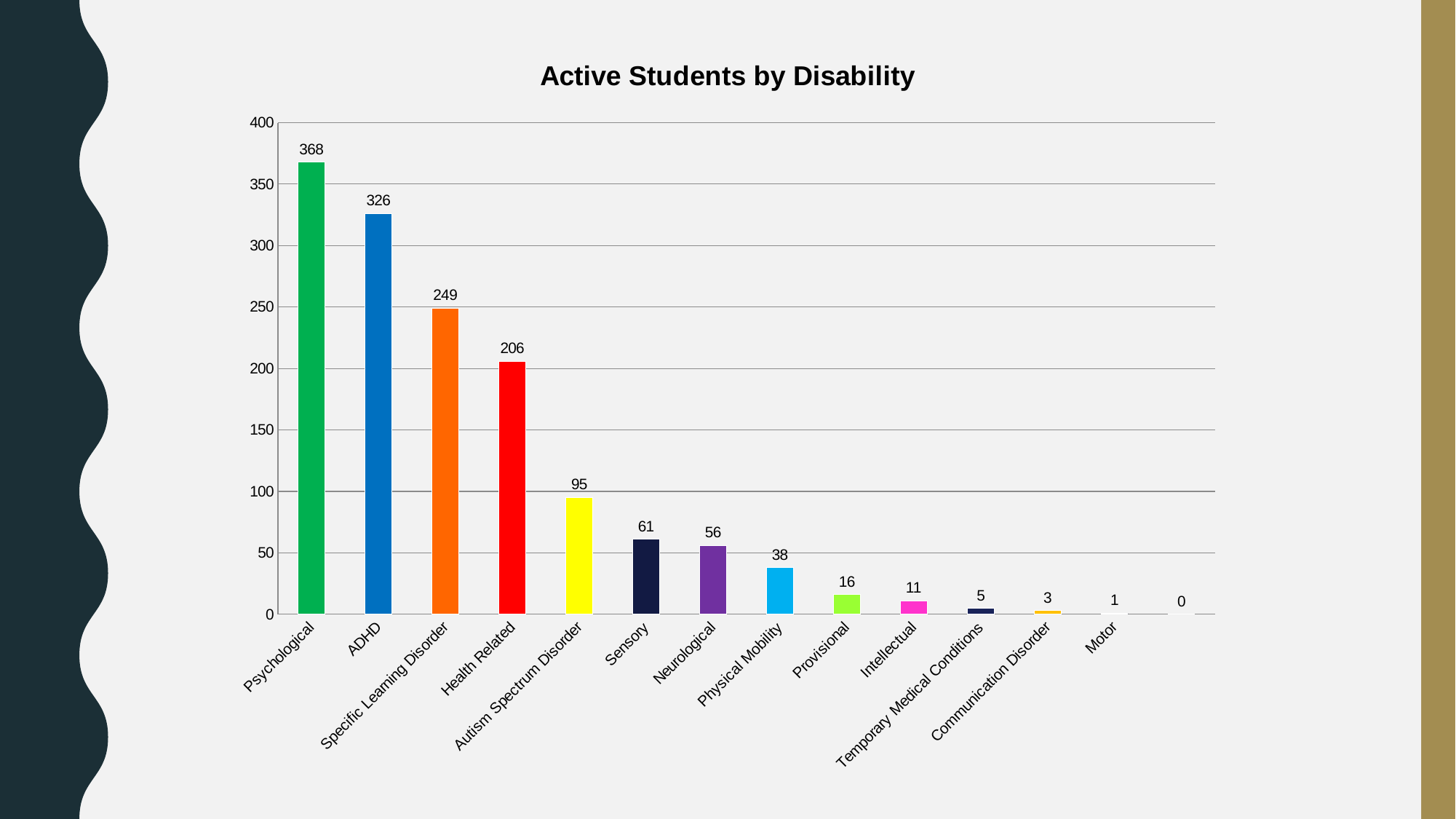
Which category has the highest value? Psychological Is the value for Health Related greater or less than 200? greater What is the value for Temporary Medical Conditions? 5 What is the title of the chart? Active Students by Disability What is the value for Motor? 1 What kind of chart is shown on the slide? bar chart What is the difference between the values for Specific Learning Disorder and Health Related? 43 Which is larger, the value for Sensory or the value for Neurological? Sensory Which is larger, the value for Provisional or the value for Intellectual? Provisional What is the value for Autism Spectrum Disorder? 95 What is the value for Psychological? 368 What is the difference between the values for Psychological and ADHD? 42